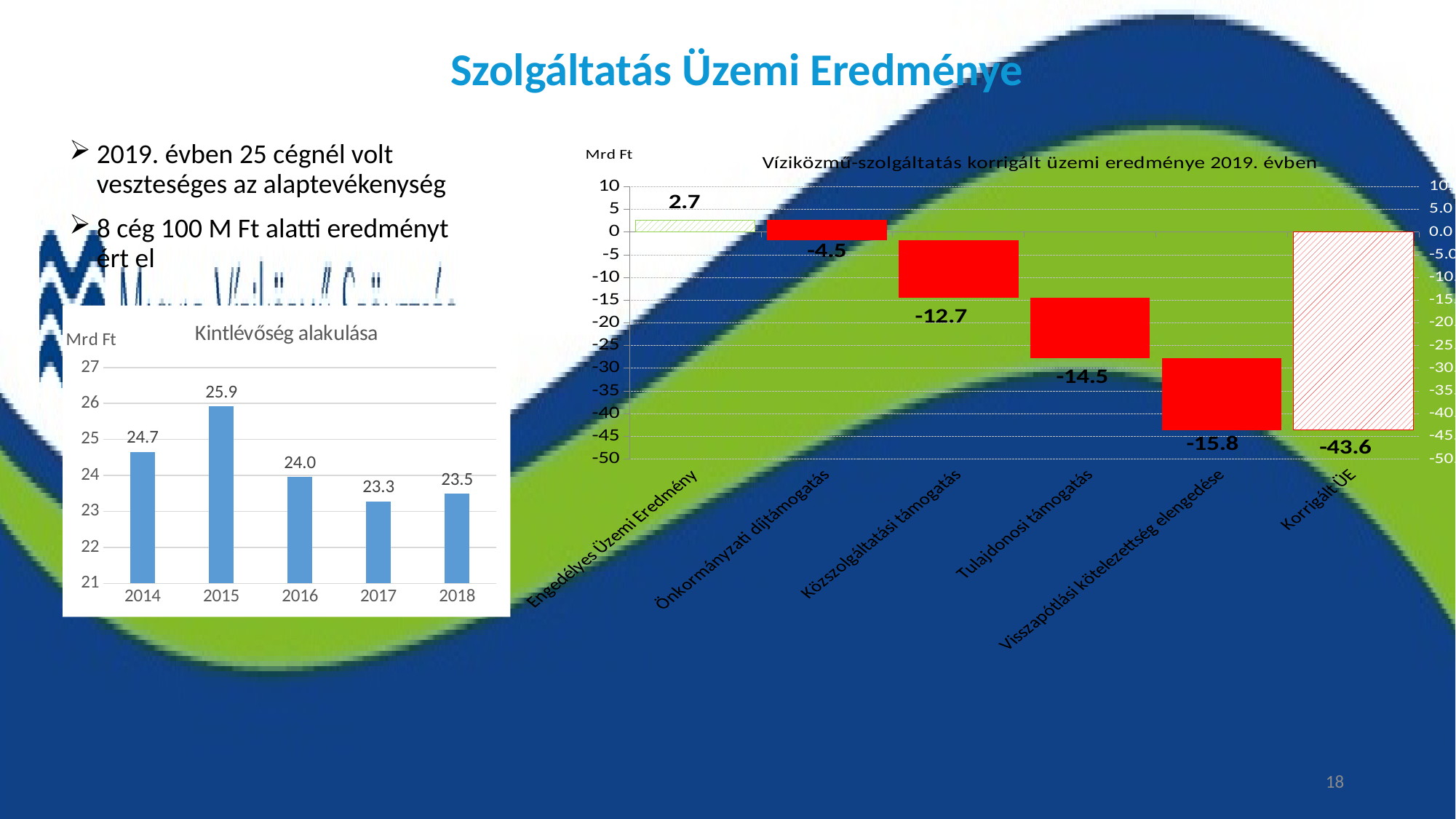
In the 'Víziközmű-szolgáltatás korrigált üzemi eredménye 2019. évben' chart, what is the value for Tulajdonosi támogatás? -14.5 In the 'Kintlévőség alakulása' chart, what is the difference between the values for 2015 and 2016? 1.9 In the 'Víziközmű-szolgáltatás korrigált üzemi eredménye 2019. évben' chart, what is the value for Engedélyes Üzemi Eredmény? 2.7 In the 'Kintlévőség alakulása' chart, which year has the highest value? 2015 In the 'Kintlévőség alakulása' chart, what is the value for 2015? 25.9 In the 'Kintlévőség alakulása' chart, what is the value for 2017? 23.3 In the 'Víziközmű-szolgáltatás korrigált üzemi eredménye 2019. évben' chart, what is the value for Korrigált ÜE? -43.6 In the 'Víziközmű-szolgáltatás korrigált üzemi eredménye 2019. évben' chart, how many categories are shown on the x axis? 6 What kind of chart is the 'Kintlévőség alakulása' chart? bar chart In the 'Kintlévőség alakulása' chart, which year has the lowest value? 2017 In the 'Kintlévőség alakulása' chart, how many years are shown on the x axis? 5 In the 'Víziközmű-szolgáltatás korrigált üzemi eredménye 2019. évben' chart, which of Önkormányzati díjtámogatás or Közszolgáltatási támogatás has the larger value? Önkormányzati díjtámogatás